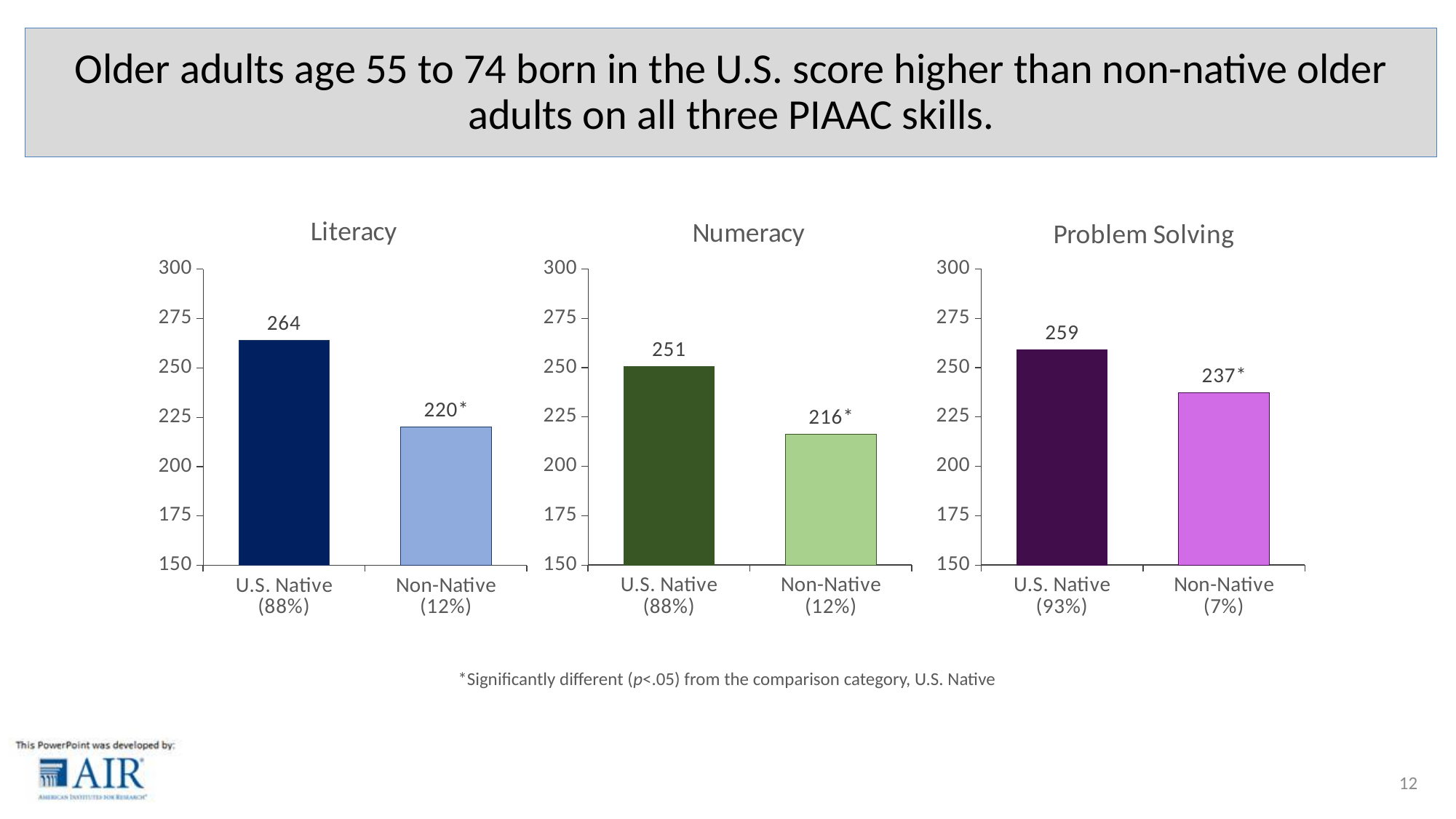
How many categories are shown in the Problem Solving chart? 2 What kind of chart is the Literacy chart? Bar chart In the Problem Solving chart, what is the value for Non-Native (7%)? 237 In the Literacy chart, what is the difference between the U.S. Native and Non-Native values? 44 In the Numeracy chart, what is the value for U.S. Native (88%)? 251 In the Literacy chart, what is the value for U.S. Native (88%)? 264 In the Literacy chart, what is the value for Non-Native (12%)? 220 In the Numeracy chart, which category has the lowest value? Non-Native (12%) In the Problem Solving chart, which category has the higher value, U.S. Native or Non-Native? U.S. Native In the Numeracy chart, what is the difference between the U.S. Native and Non-Native values? 35 In the Numeracy chart, what is the value for Non-Native (12%)? 216 In the Problem Solving chart, what is the value for U.S. Native (93%)? 259